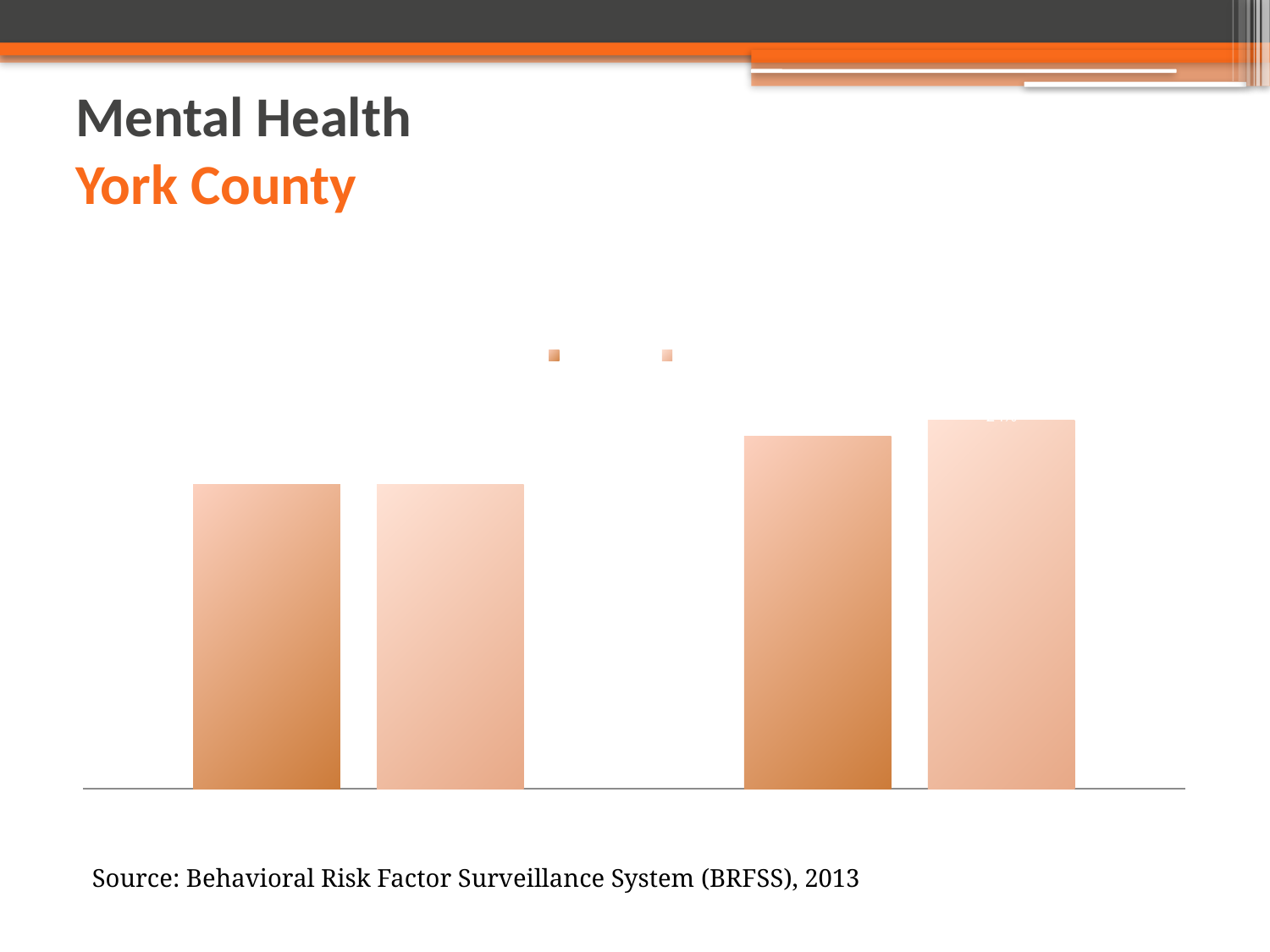
What year is given in the source line below the chart? 2013 Are the bars in the right-hand group taller or shorter than the bars in the left-hand group? taller What kind of chart is shown on the slide? bar chart How many groups of bars are shown in the chart? 2 How many series does the chart's legend list? 2 What data source is cited below the chart? Behavioral Risk Factor Surveillance System (BRFSS), 2013 Which bar is the tallest in the chart: the leftmost, second, third, or rightmost? rightmost How many bars are plotted in the chart? 4